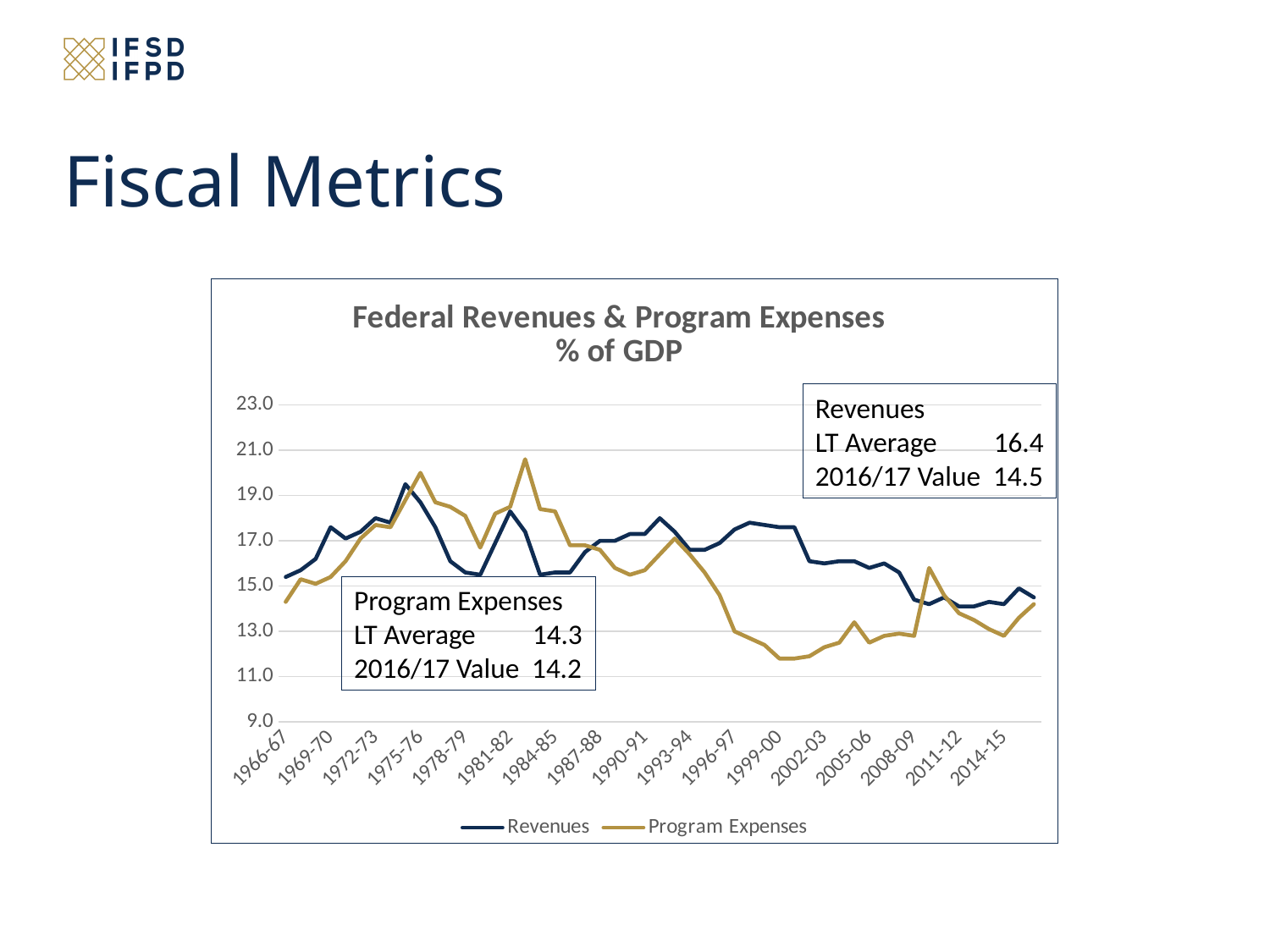
What is the long-term (LT) average for Revenues shown in the annotation box? 16.4 What is the 2016/17 value for Program Expenses shown in the annotation box? 14.2 Do Program Expenses rise or fall between 1993-94 and 1999-00? fall What kind of chart is shown on the slide? Line chart What is the title of the chart? Federal Revenues & Program Expenses % of GDP What is the 2016/17 value for Revenues shown in the annotation box? 14.5 Is the value for Program Expenses in 1999-00 greater or less than 13.0? less Which is larger, the 2016/17 value for Revenues or the 2016/17 value for Program Expenses? Revenues What is the difference between the LT Average for Revenues and the LT Average for Program Expenses? 2.1 How many series does the legend list? 2 How many year labels are shown on the x axis? 17